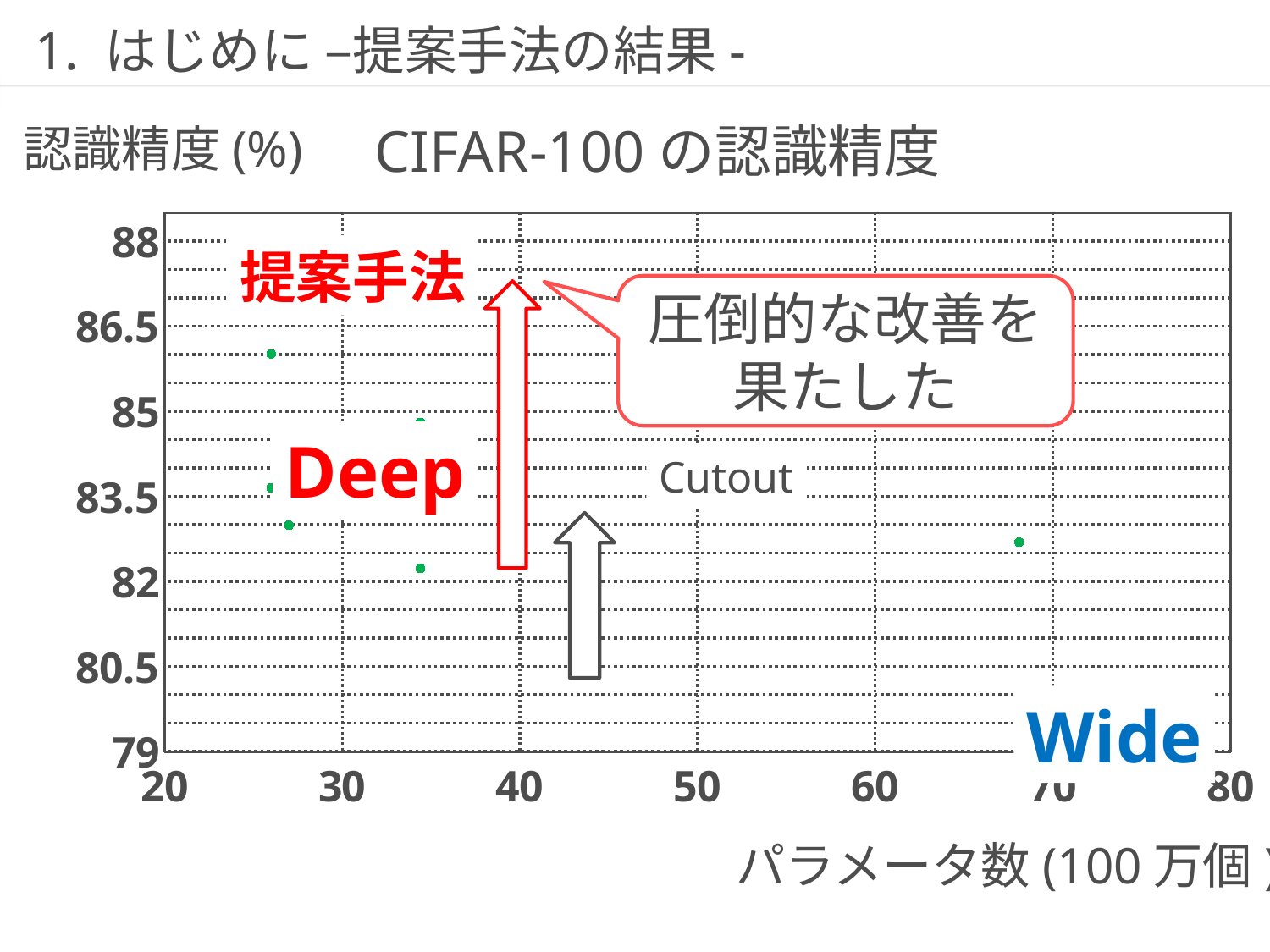
Is the lowest plotted accuracy value greater or less than 80.5? greater Is the highest plotted accuracy value greater or less than 85? greater What is the lowest value shown on the y axis? 79 What kind of chart is shown on the slide? scatter chart What is the label of the x axis of the chart? パラメータ数 (100 万個) Is the accuracy of the rightmost plotted point (near 68 on the x axis) greater or less than 85? less Which has the higher accuracy: the point near 26 on the x axis at the top of the cluster, or the rightmost point near 68? the point near 26 What is the title of the chart? CIFAR-100 の認識精度